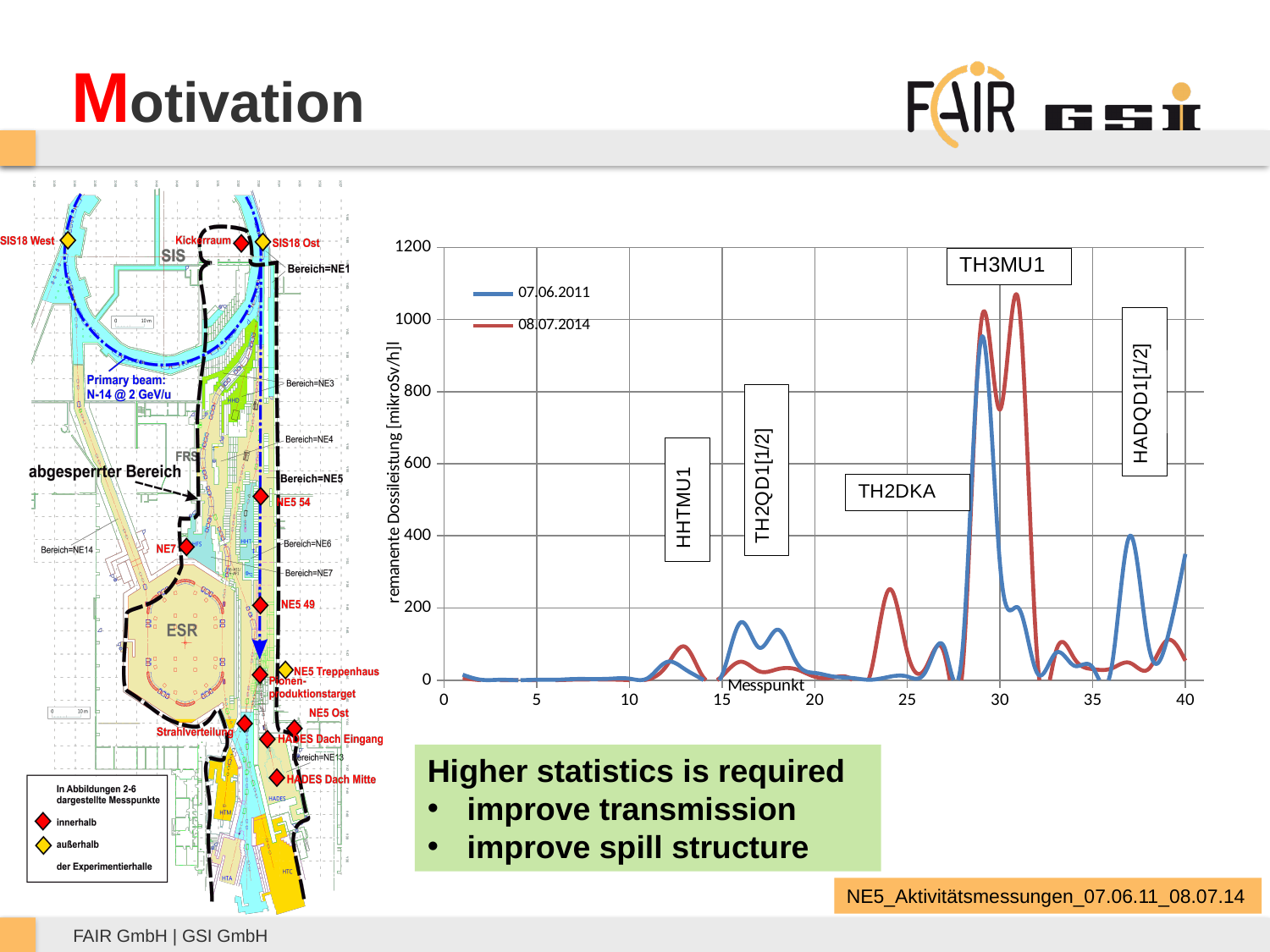
Is the value of the 07.06.2011 series at Messpunkt 37 greater or less than 200? greater Is the value of the 08.07.2014 series at Messpunkt 24 greater or less than 200? greater Is the highest value of the 07.06.2011 series greater or less than 800? greater Which two dates are listed in the chart legend? 07.06.2011 and 08.07.2014 How many series does the legend of the chart list? 2 Which annotation label is placed above the highest peak of the chart? TH3MU1 What is the label of the y axis of the chart? remanente Dosisleistung [mikroSv/h] Which series, 07.06.2011 or 08.07.2014, reaches the higher peak value on the chart? 08.07.2014 What type of chart is shown on the slide? line chart